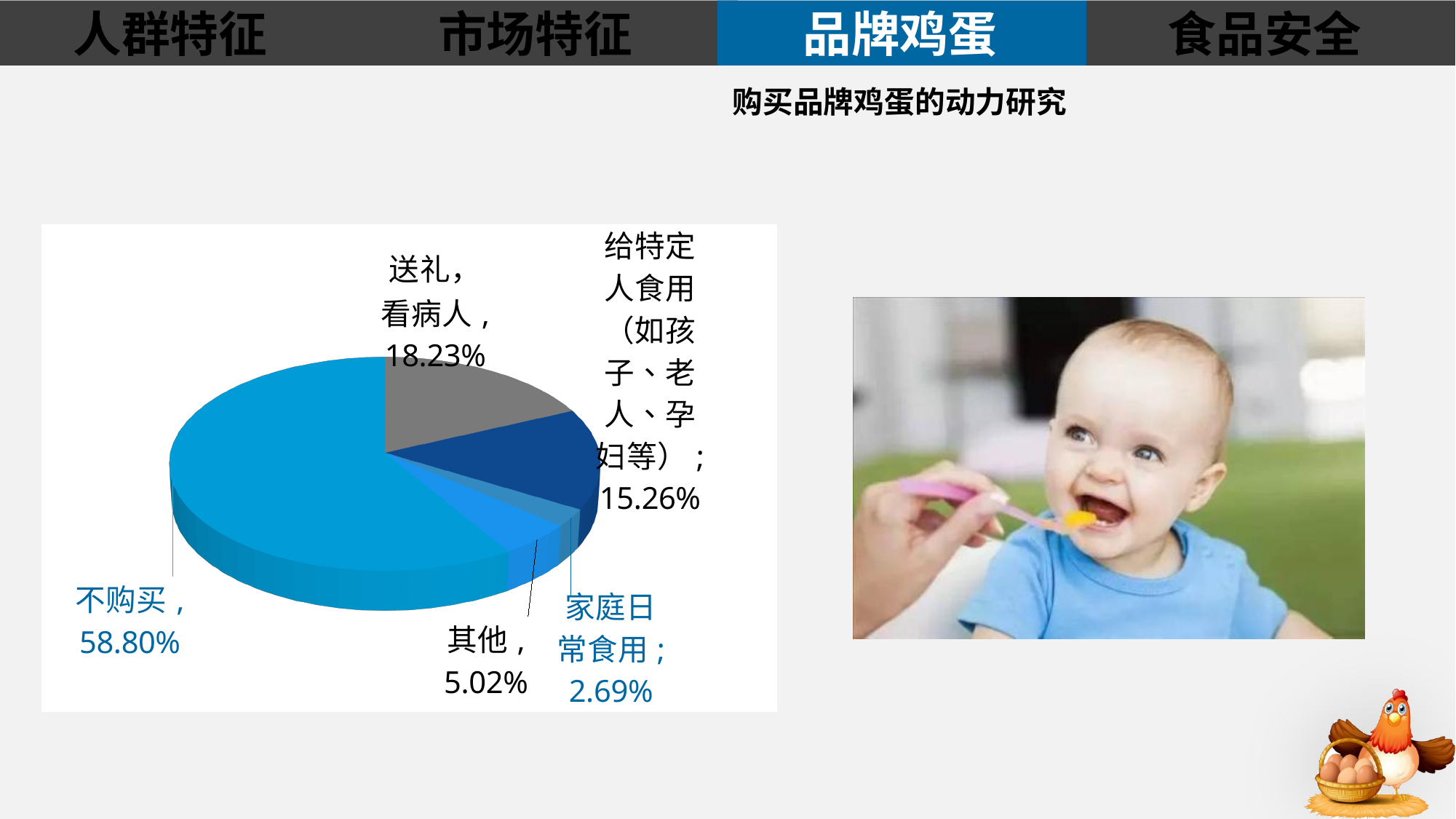
What share of the pie does 不购买 account for? 58.80% Which category has the smallest slice of the pie? 家庭日常食用 What percentage is labelled for 给特定人食用（如孩子、老人、孕妇等）? 15.26% What is the title shown above the chart? 购买品牌鸡蛋的动力研究 What is the difference between the values for 送礼，看病人 and 给特定人食用（如孩子、老人、孕妇等）? 2.97% Which category has the largest slice of the pie? 不购买 Which is larger, the value for 其他 or the value for 家庭日常食用? 其他 How many slices does the pie chart have? 5 What is the value for 家庭日常食用? 2.69% What is the value shown for 送礼，看病人? 18.23% What is the value for 其他? 5.02% What kind of chart is shown on the slide? Pie chart